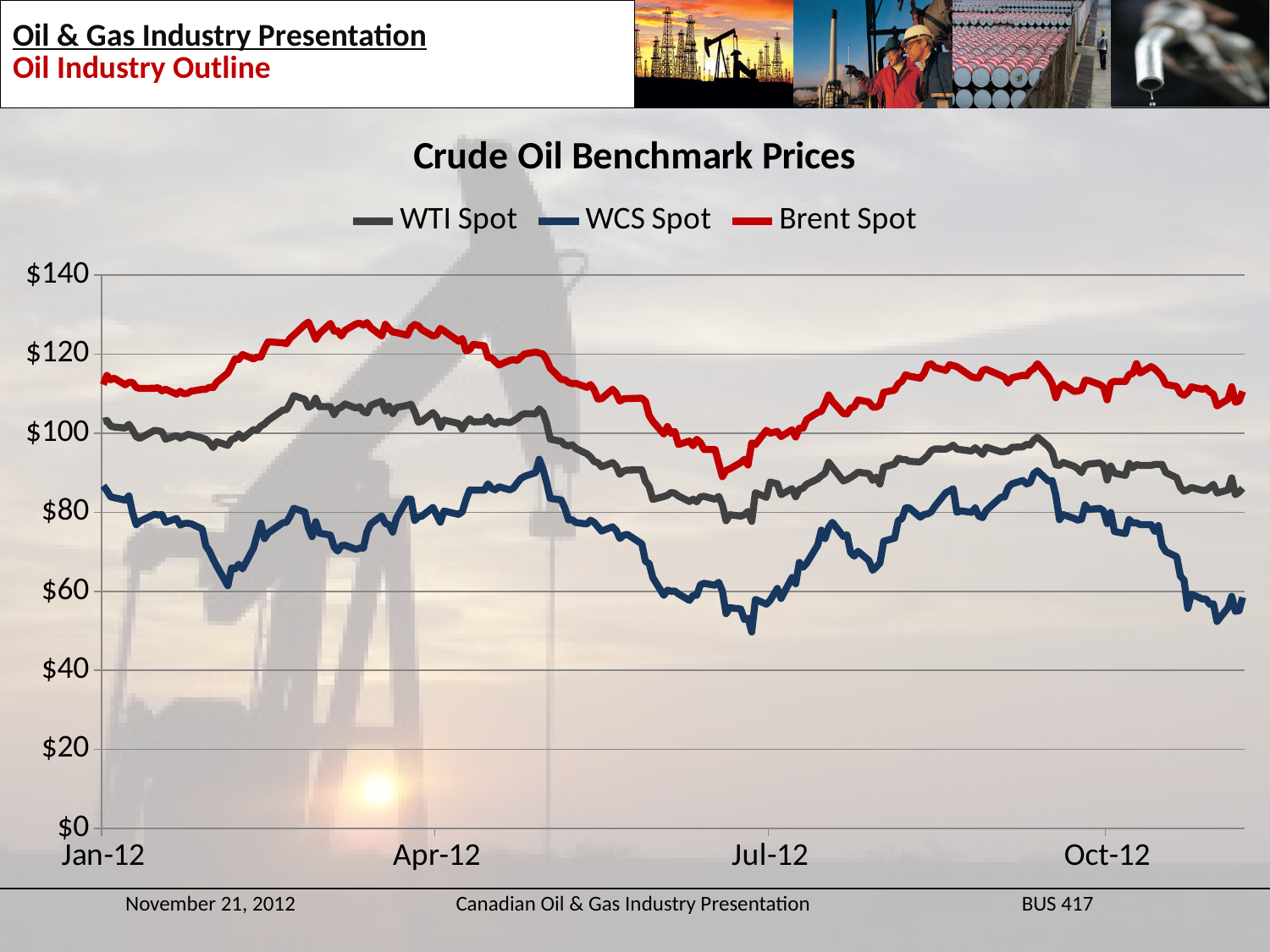
Which series is drawn in red? Brent Spot How many series does the legend list? 3 At Jul-12, which is higher, Brent Spot or WCS Spot? Brent Spot Which series has the highest prices across the whole period? Brent Spot Does the WCS Spot price rise or fall from Oct-12 to the end of the chart? fall What kind of chart is shown on the slide? line chart Is the Brent Spot value at Apr-12 greater or less than $120? greater Which series has the lowest prices across the whole period? WCS Spot Is the WTI Spot value at Jul-12 greater or less than $100? less Is the Brent Spot value at Jan-12 greater or less than $100? greater What is the title of the chart? Crude Oil Benchmark Prices